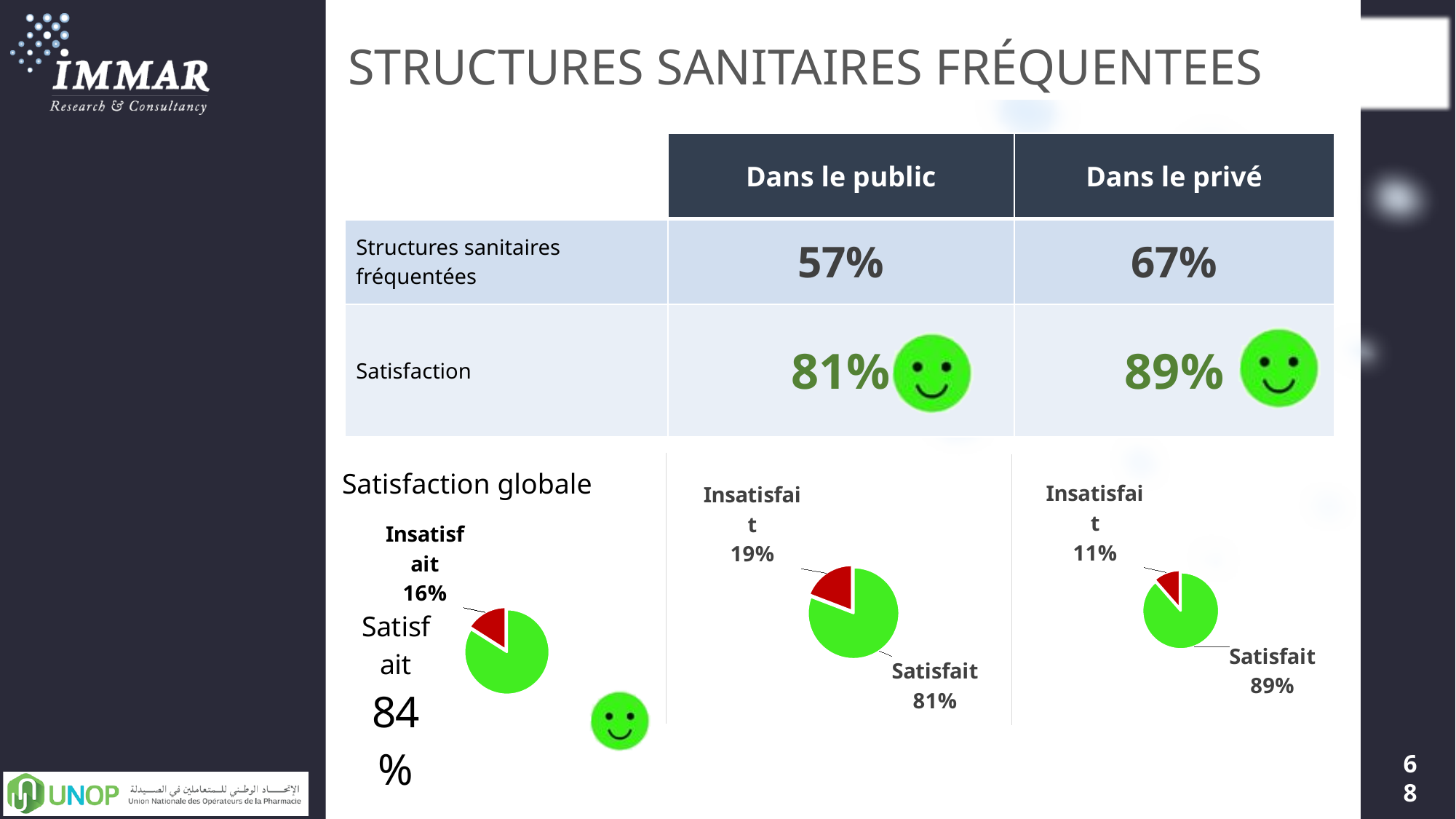
In the middle pie chart, what is the value for 'Satisfait'? 81% How many slices does the middle pie chart have? 2 In the right pie chart, what is the value for 'Satisfait'? 89% In the right pie chart, which slice is the largest? Satisfait In the middle pie chart, what is the value for 'Insatisfait'? 19% In the middle pie chart, which slice is the smallest? Insatisfait In the left pie chart titled 'Satisfaction globale', what share is labelled 'Insatisfait'? 16% What is the difference between the 'Satisfait' share in the right pie chart and the 'Satisfait' share in the middle pie chart? 8% What type of chart is the left chart titled 'Satisfaction globale'? Pie chart Which is larger: the 'Insatisfait' share in the middle pie chart or the 'Insatisfait' share in the right pie chart? Middle pie chart In the right pie chart, what is the value for 'Insatisfait'? 11% In the left pie chart titled 'Satisfaction globale', what share is labelled 'Satisfait'? 84%